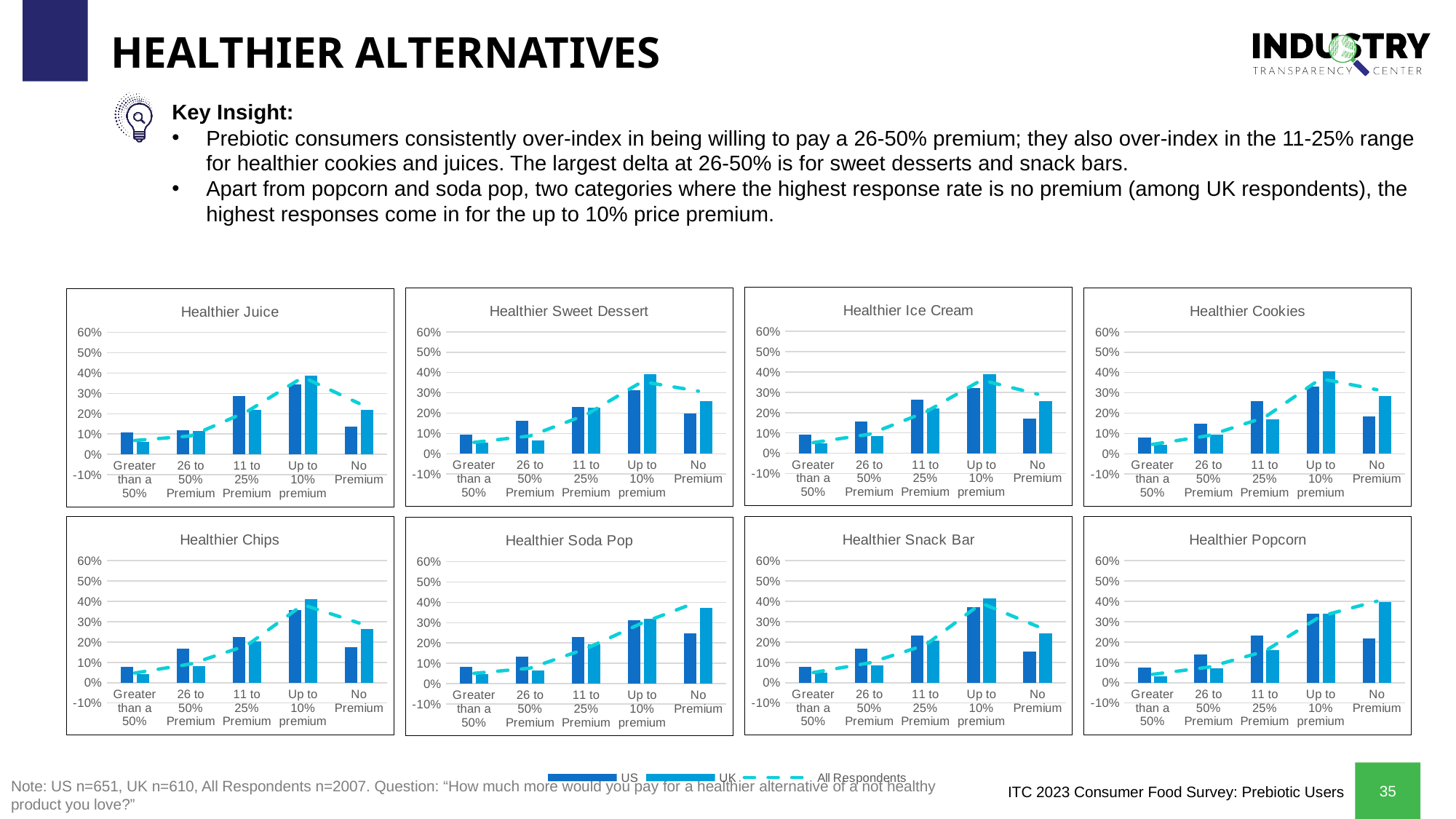
How many series does the legend list for the charts? 3 In the Healthier Popcorn chart, which category has the highest UK value? No Premium In the Healthier Soda Pop chart, which is larger for No Premium, the US value or the UK value? UK In the Healthier Cookies chart, is the UK value for Up to 10% premium greater or less than 30%? greater In the Healthier Soda Pop chart, which category has the highest UK value? No Premium In the Healthier Popcorn chart, which category has the lowest UK value? Greater than a 50% How many price-premium categories are shown on the x axis of the Healthier Chips chart? 5 What kind of chart is the Healthier Juice chart? combination bar and line chart What are the three entries in the shared legend below the charts? US, UK, All Respondents In the Healthier Juice chart, which category has the highest US value? Up to 10% premium In the Healthier Juice chart, is the UK value for Greater than a 50% greater or less than 10%? less In the Healthier Sweet Dessert chart, which is larger for 26 to 50% Premium, the US value or the UK value? US